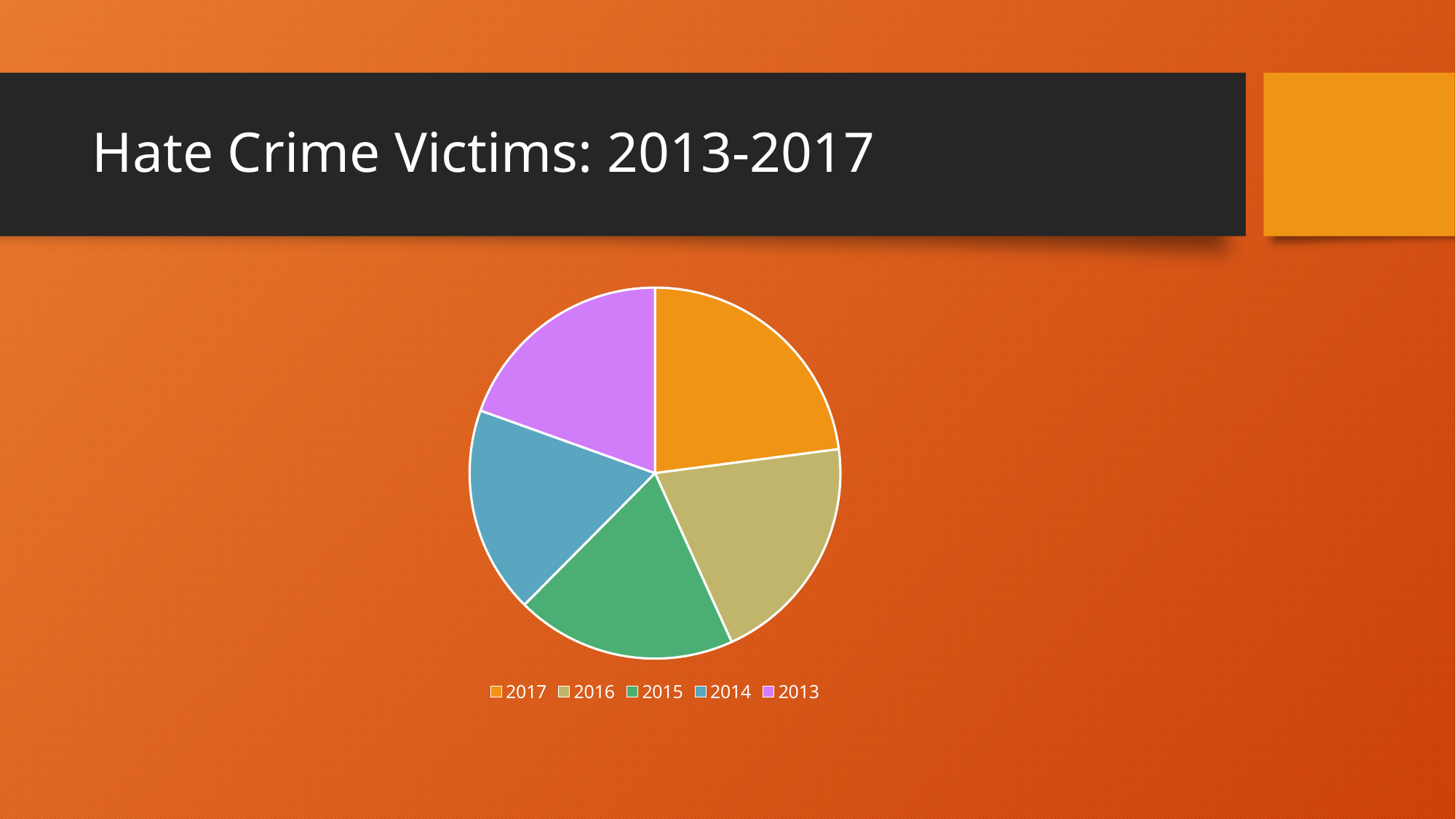
How many slices does the pie chart have? 5 Which slice is larger in the pie chart, 2017 or 2014? 2017 What kind of chart is shown on the slide? pie chart What is the title of the slide containing the pie chart? Hate Crime Victims: 2013-2017 Which year is represented by the orange slice of the pie chart? 2017 How many entries does the legend of the pie chart list? 5